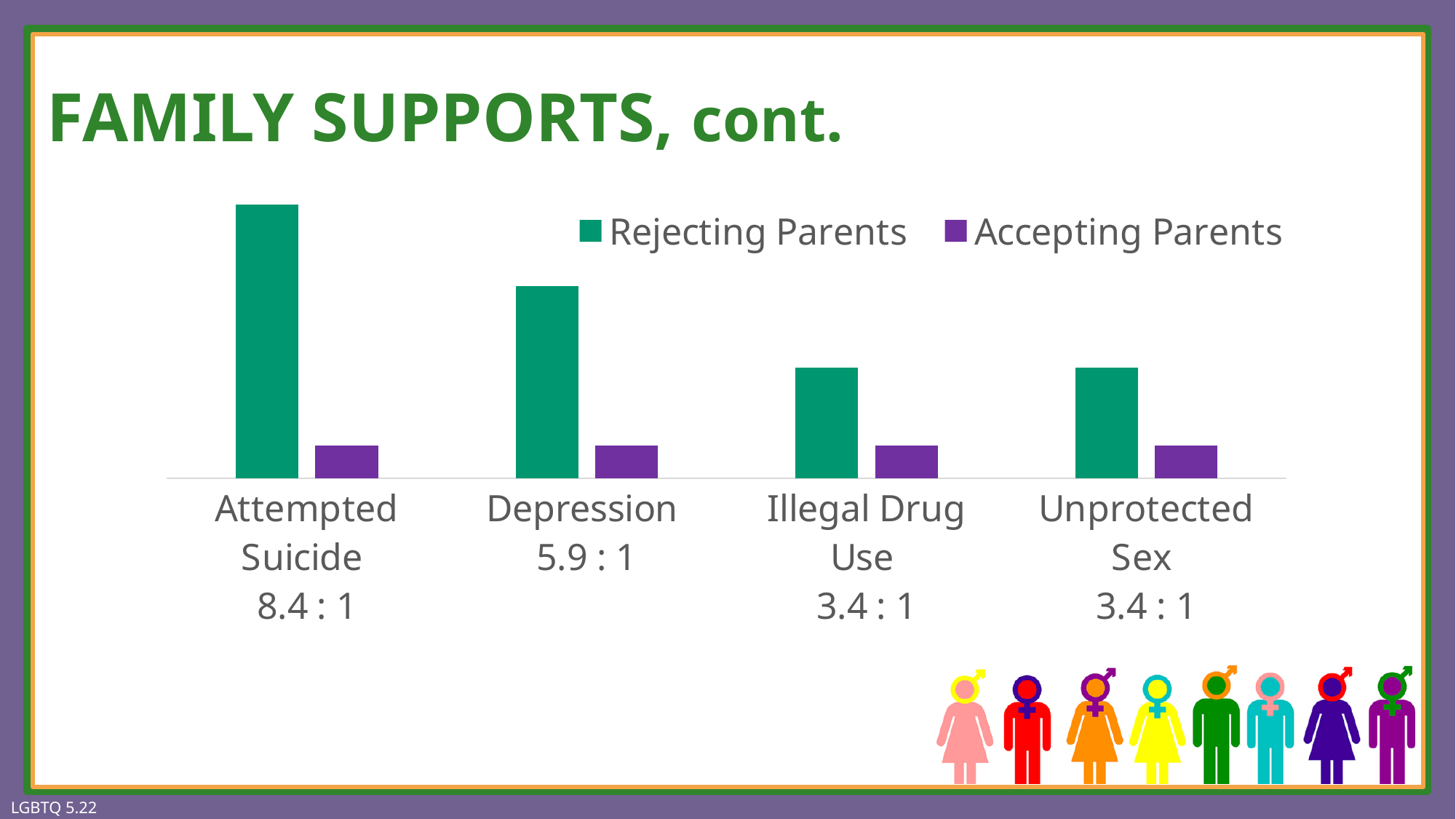
What ratio is printed under the Depression category label? 5.9 : 1 For Attempted Suicide, which is larger: Rejecting Parents or Accepting Parents? Rejecting Parents Which category has the highest Rejecting Parents bar? Attempted Suicide Do the Rejecting Parents bars rise or fall from left to right across the categories? fall What ratio is printed under the Illegal Drug Use category label? 3.4 : 1 How many series does the legend list? 2 How many categories are shown on the x axis? 4 Which Rejecting Parents bar is taller: Depression or Illegal Drug Use? Depression Which colour represents the Accepting Parents series in the legend? purple What ratio is printed under the Attempted Suicide category label? 8.4 : 1 What kind of chart is shown on the slide? bar chart Which Rejecting Parents bar is taller: Attempted Suicide or Unprotected Sex? Attempted Suicide